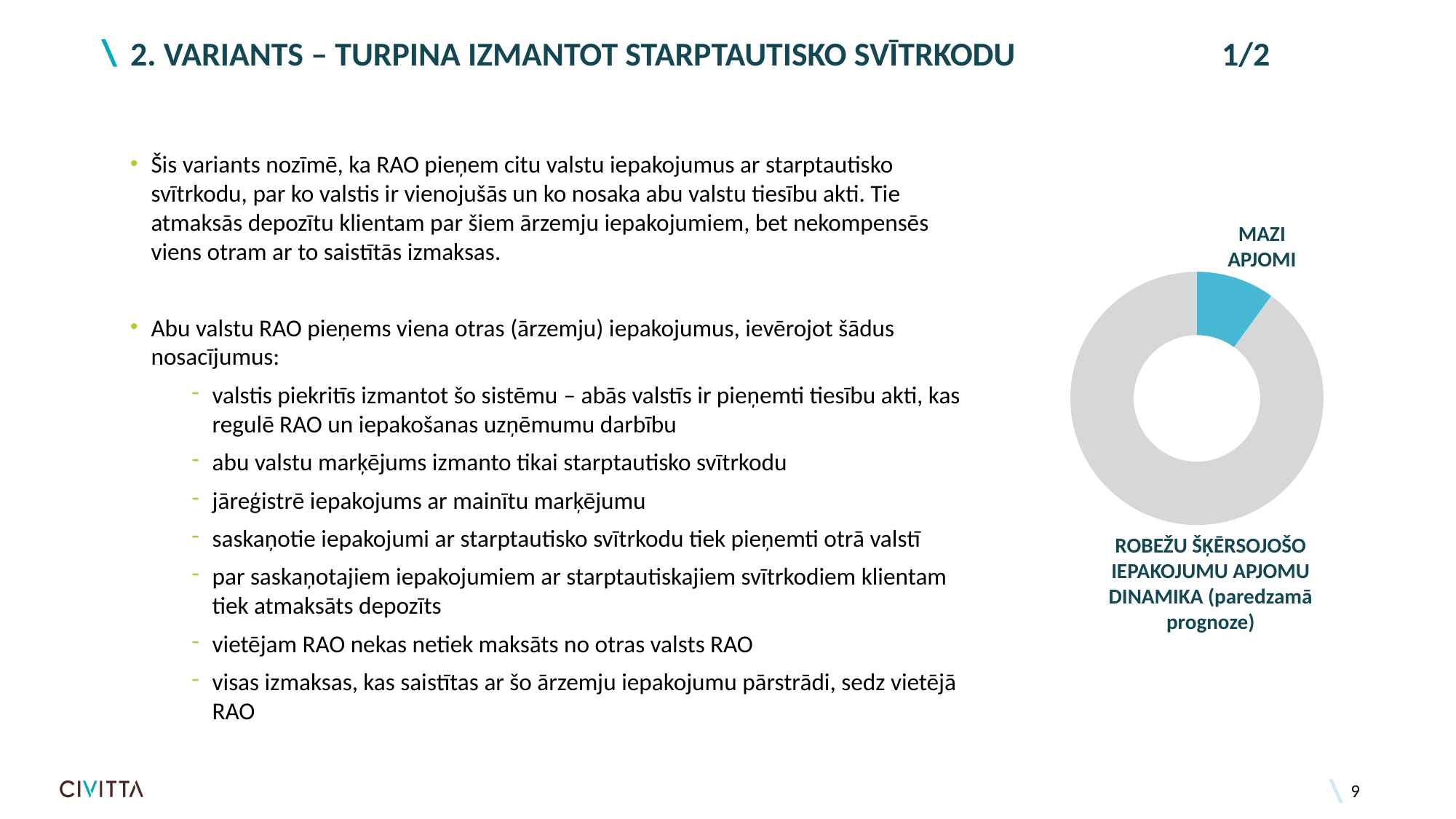
How many slices does the donut chart have? 2 Is the "MAZI APJOMI" slice the larger or the smaller slice of the donut chart? The smaller What kind of chart is shown on the slide? Donut (pie) chart Which slice of the donut chart is larger, the blue "MAZI APJOMI" slice or the grey slice? The grey slice What is the title of the donut chart? ROBEŽU ŠĶĒRSOJOŠO IEPAKOJUMU APJOMU DINAMIKA (paredzamā prognoze) What colour is the "MAZI APJOMI" slice in the donut chart? Blue